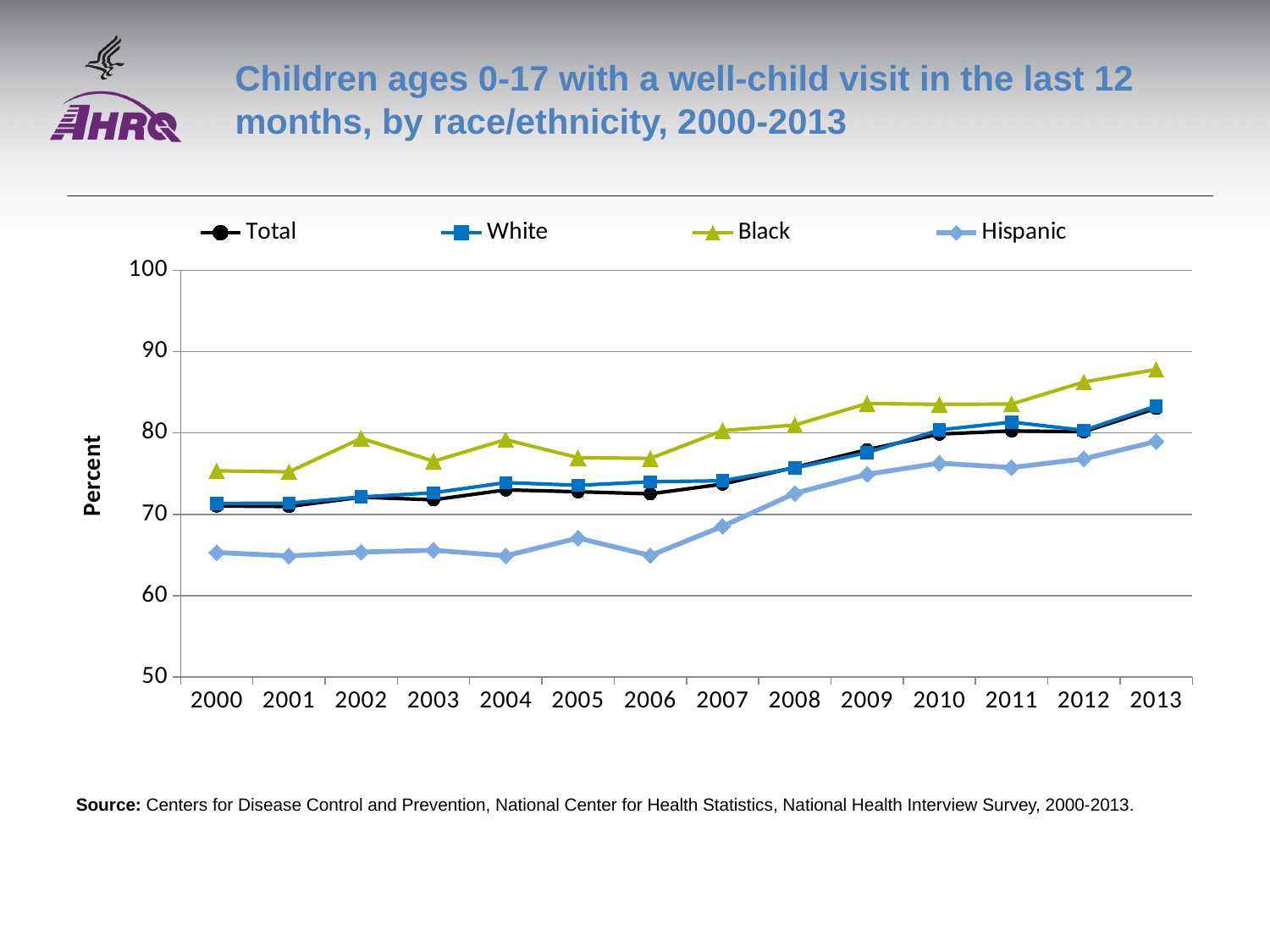
What kind of chart is shown on the slide? Line chart Which series has the lowest value in 2000? Hispanic What is the label on the y axis? Percent Is the value for Black in 2013 greater or less than 80? greater Which series has the highest value in 2013? Black How many series does the legend list? 4 Is the value for Hispanic in 2006 greater or less than 70? less How many years are plotted along the x axis? 14 In 2005, which is larger: the value for White or the value for Hispanic? White In 2010, which is larger: the value for Black or the value for Hispanic? Black Is the value for White in 2013 greater or less than 80? greater Does the Hispanic series rise or fall from 2006 to 2013? Rise